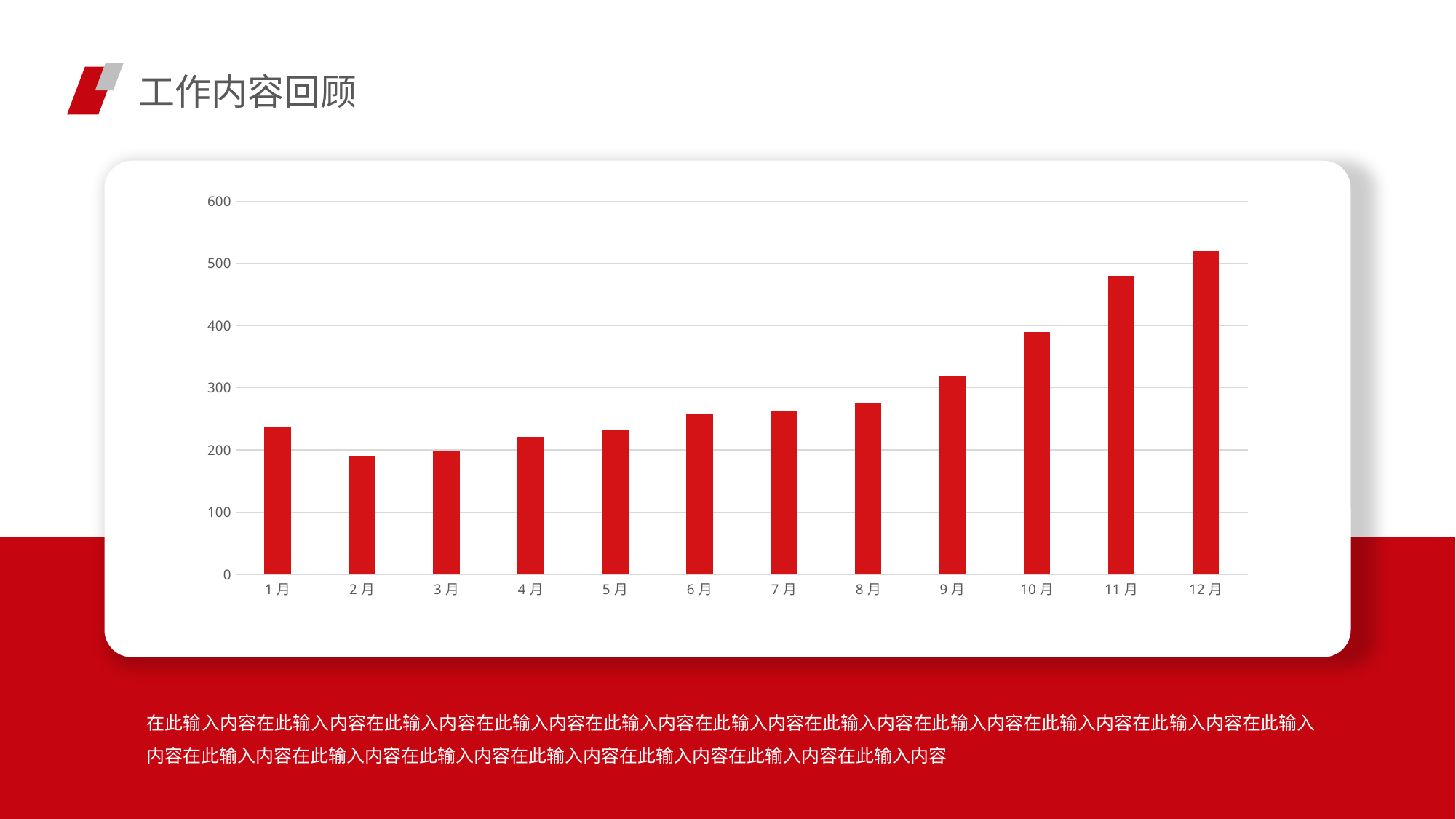
Is the value for 2 月 greater or less than 200? less Which month has the highest bar in the chart? 12 月 Is the value for 8 月 greater or less than 300? less Is the value for 9 月 greater or less than 300? greater Which month has the lowest bar in the chart? 2 月 Do the values generally rise or fall from 1 月 to 12 月? rise How many months are shown on the x axis of the chart? 12 What is the title of the slide containing the chart? 工作内容回顾 What kind of chart is shown on the slide? bar chart Which is larger, the value for 11 月 or the value for 10 月? 11 月